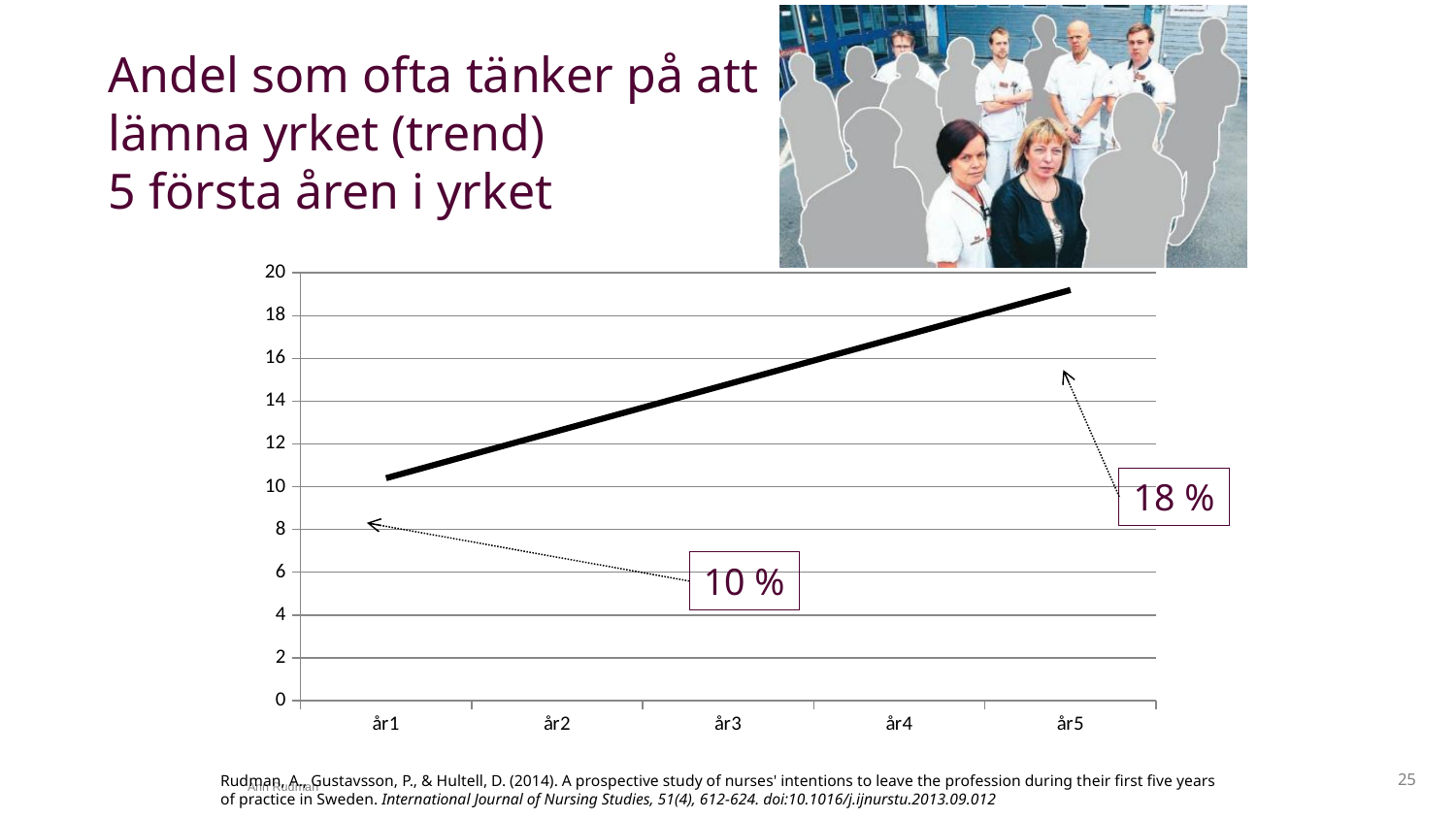
What kind of chart is shown on the slide? line chart Is the value for år1 greater or less than 12? less How many years (points) are shown along the x axis of the chart? 5 What value does the callout label give for år5? 18 % Is the value for år5 greater or less than 16? greater Which year has the highest value on the chart? år5 Which is larger, the value for år5 or the value for år1? år5 What is the highest tick value shown on the y axis? 20 According to the callout labels, by how many percentage points does the value increase from år1 to år5? 8 What value does the callout label give for år1? 10 % Which year has the lowest value on the chart? år1 Does the line rise or fall from år1 to år5? rises